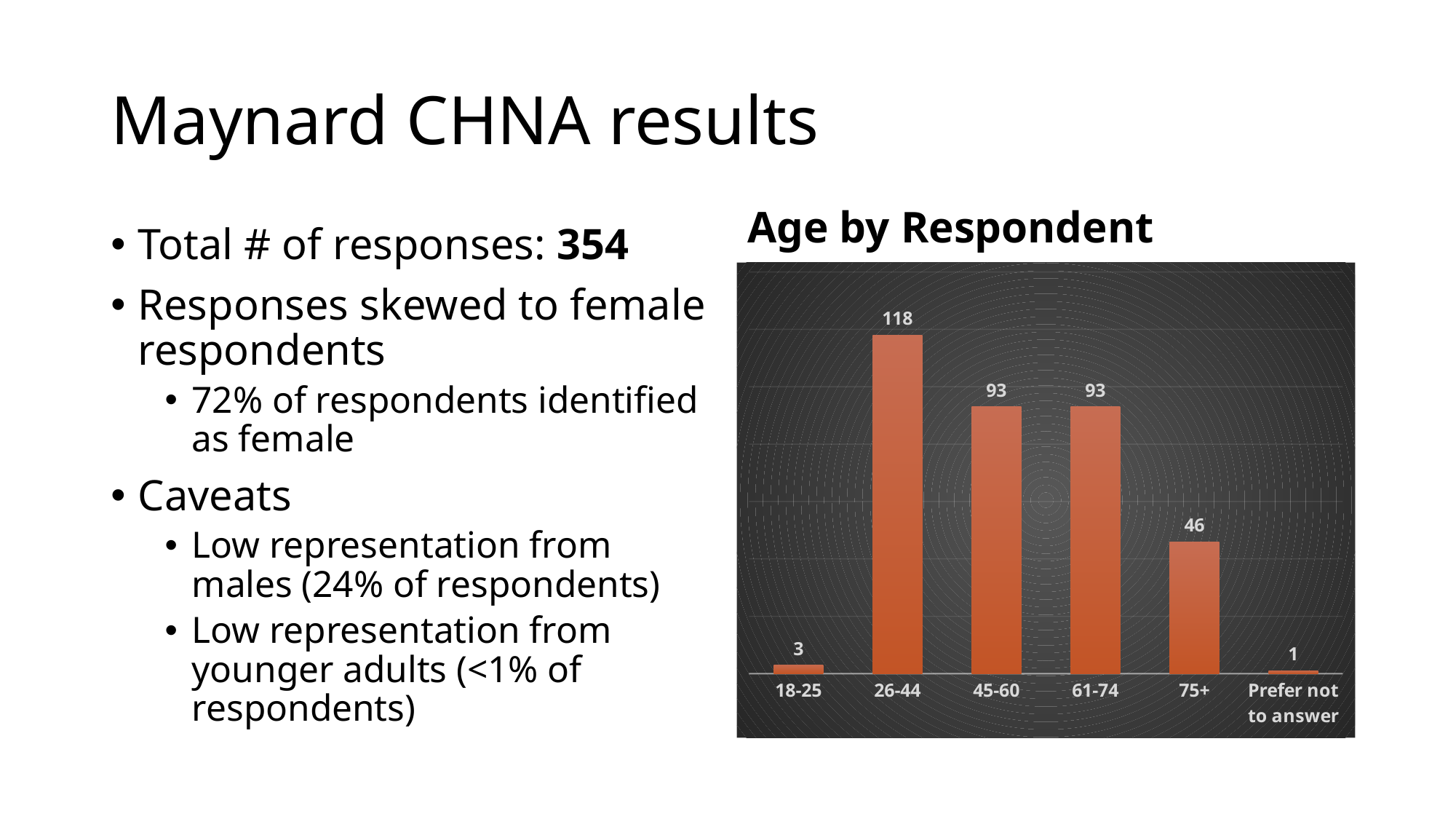
What is the value for the 75+ age group? 46 What is the difference between the values for 75+ and 18-25? 43 Which is larger, the value for 61-74 or the value for 75+? 61-74 Which age group has the highest number of respondents? 26-44 What is the value for the 26-44 age group in the Age by Respondent chart? 118 What kind of chart is shown on the slide? Bar chart What is the difference between the values for 26-44 and 45-60? 25 What is the value for the 18-25 age group? 3 How many categories are shown on the x axis of the chart? 6 What is the value for the 'Prefer not to answer' category? 1 What is the title of the chart on the slide? Age by Respondent Which category has the lowest value in the chart? Prefer not to answer